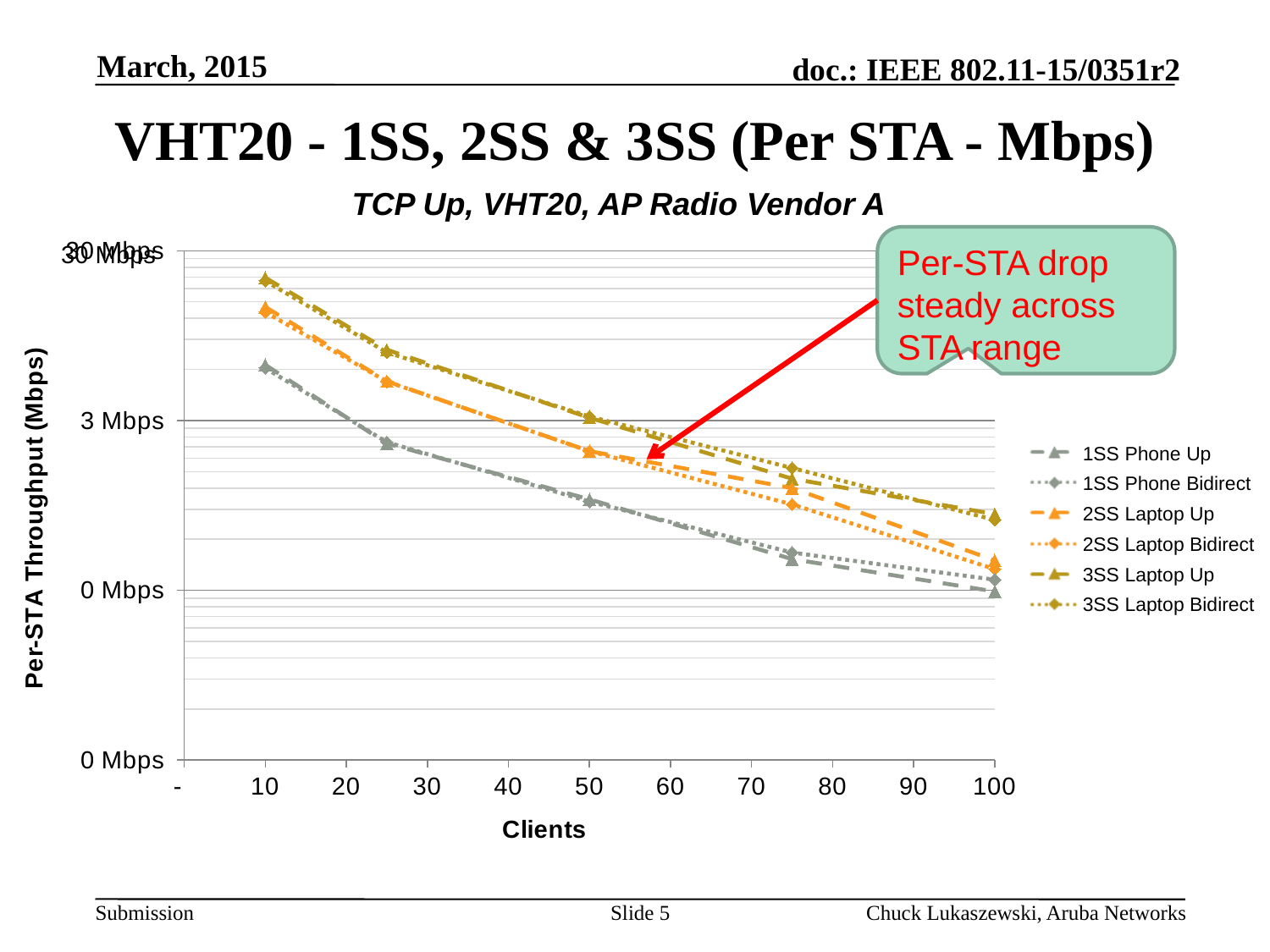
What is the title of the chart? TCP Up, VHT20, AP Radio Vendor A Is the value for 1SS Phone Bidirect at 50 clients greater or less than 3 Mbps? less What kind of chart is shown on the slide? line chart At 10 clients, which is larger: the value for 3SS Laptop Up or the value for 1SS Phone Up? 3SS Laptop Up What is the label of the x axis? Clients Do the values for 1SS Phone Up rise or fall as the number of clients increases? fall Do the values for 3SS Laptop Bidirect rise or fall as the number of clients increases? fall How many data points are plotted for the 2SS Laptop Up series? 5 Is the value for 1SS Phone Up at 100 clients greater or less than 3 Mbps? less How many series does the legend list? 6 Is the value for 2SS Laptop Up at 25 clients greater or less than 3 Mbps? greater